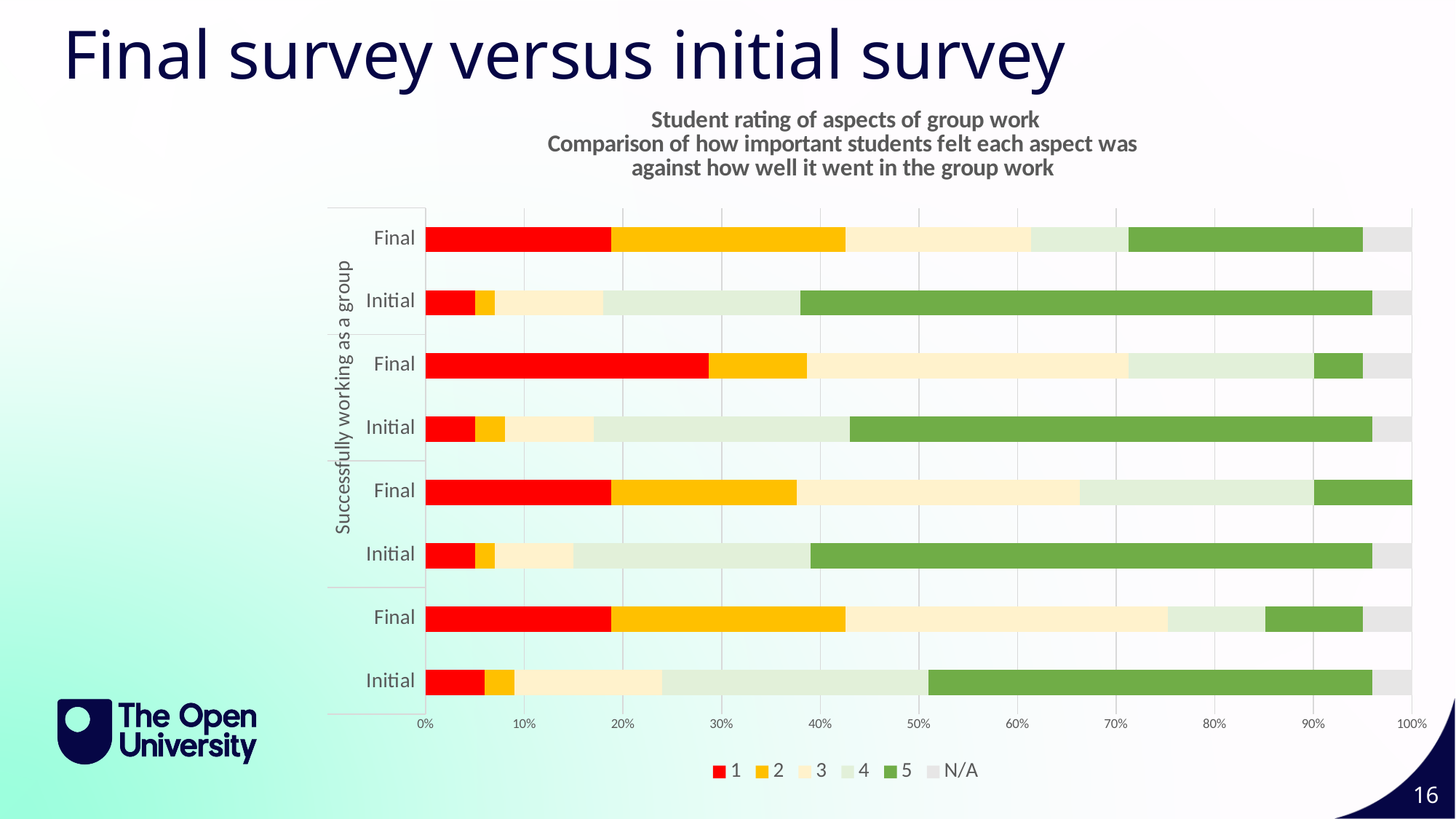
In the second Final bar from the top, is the share for rating 1 (red) greater or less than 20%? greater How many bars are plotted in the chart? 8 What is the highest value shown on the horizontal axis? 100% In the topmost Initial bar, is the share for rating 1 (red) greater or less than 10%? less What are the legend entries of the chart? 1, 2, 3, 4, 5, N/A What kind of chart is shown on the slide? Stacked bar chart What is the first line of the chart title? Student rating of aspects of group work In the bottom Initial bar, which segment is larger, rating 5 (green) or rating 1 (red)? Rating 5 (green) How many series does the chart legend list? 6 Which category label is readable on the vertical axis of the chart? Successfully working as a group In the bottom Initial bar, does the rating 5 (green) segment start before or after 50%? after In the topmost pair of bars, which bar has the larger rating 1 (red) segment, Final or Initial? Final